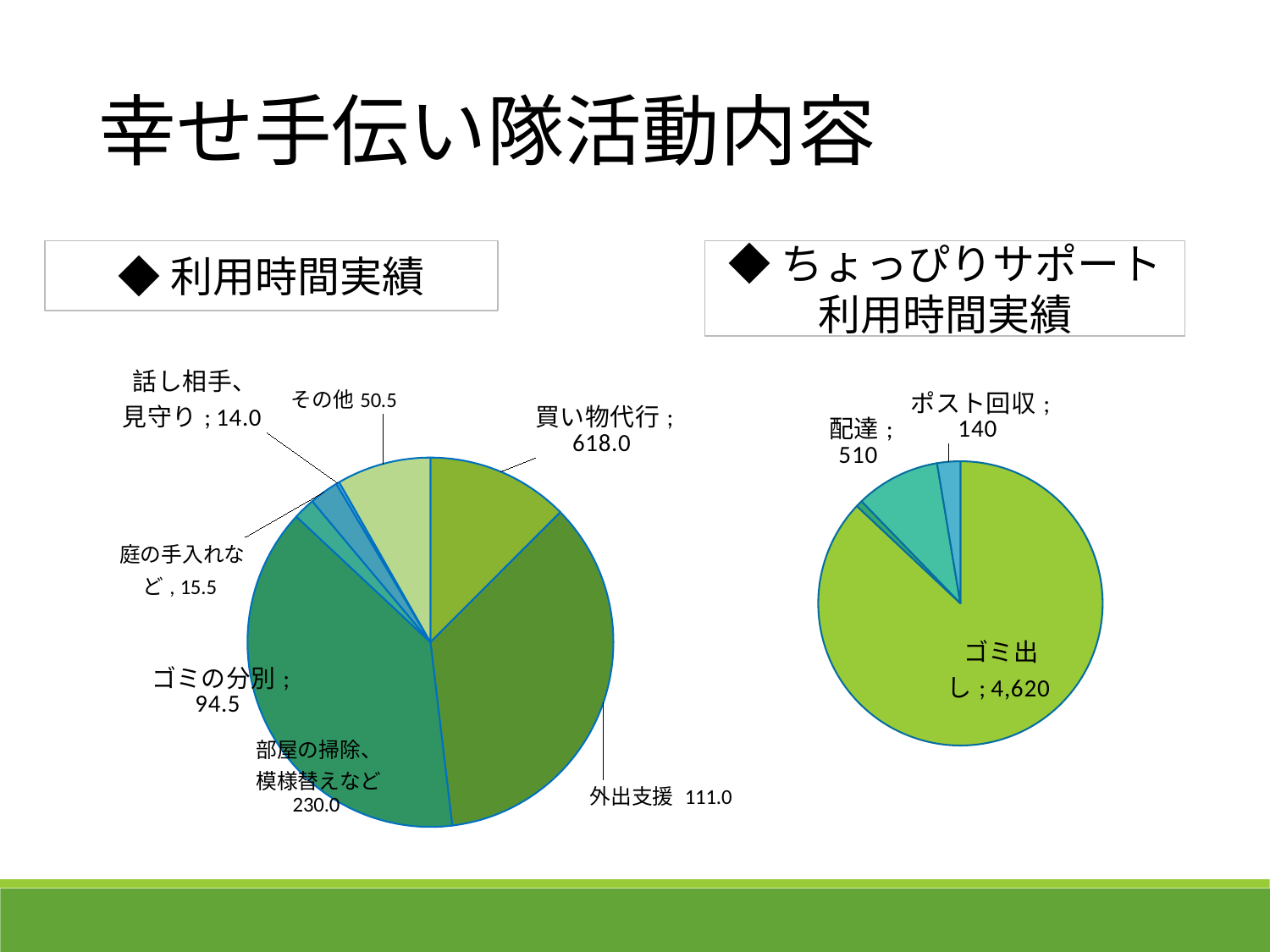
In the left pie chart (利用時間実績), what is the value for 買い物代行? 618.0 In the right pie chart (ちょっぴりサポート利用時間実績), what is the value for ゴミ出し? 4,620 In the left pie chart (利用時間実績), what is the value for 部屋の掃除、模様替えなど? 230.0 In the left pie chart (利用時間実績), what is the value for 話し相手、見守り? 14.0 In the left pie chart (利用時間実績), how many categories are shown? 7 In the left pie chart (利用時間実績), what is the value for ゴミの分別? 94.5 In the left pie chart (利用時間実績), what is the difference between the values for 部屋の掃除、模様替えなど and ゴミの分別? 135.5 In the right pie chart (ちょっぴりサポート利用時間実績), what is the value for 配達? 510 In the right pie chart (ちょっぴりサポート利用時間実績), which category has the largest value? ゴミ出し What kind of chart is used for the right chart (ちょっぴりサポート利用時間実績)? Pie chart